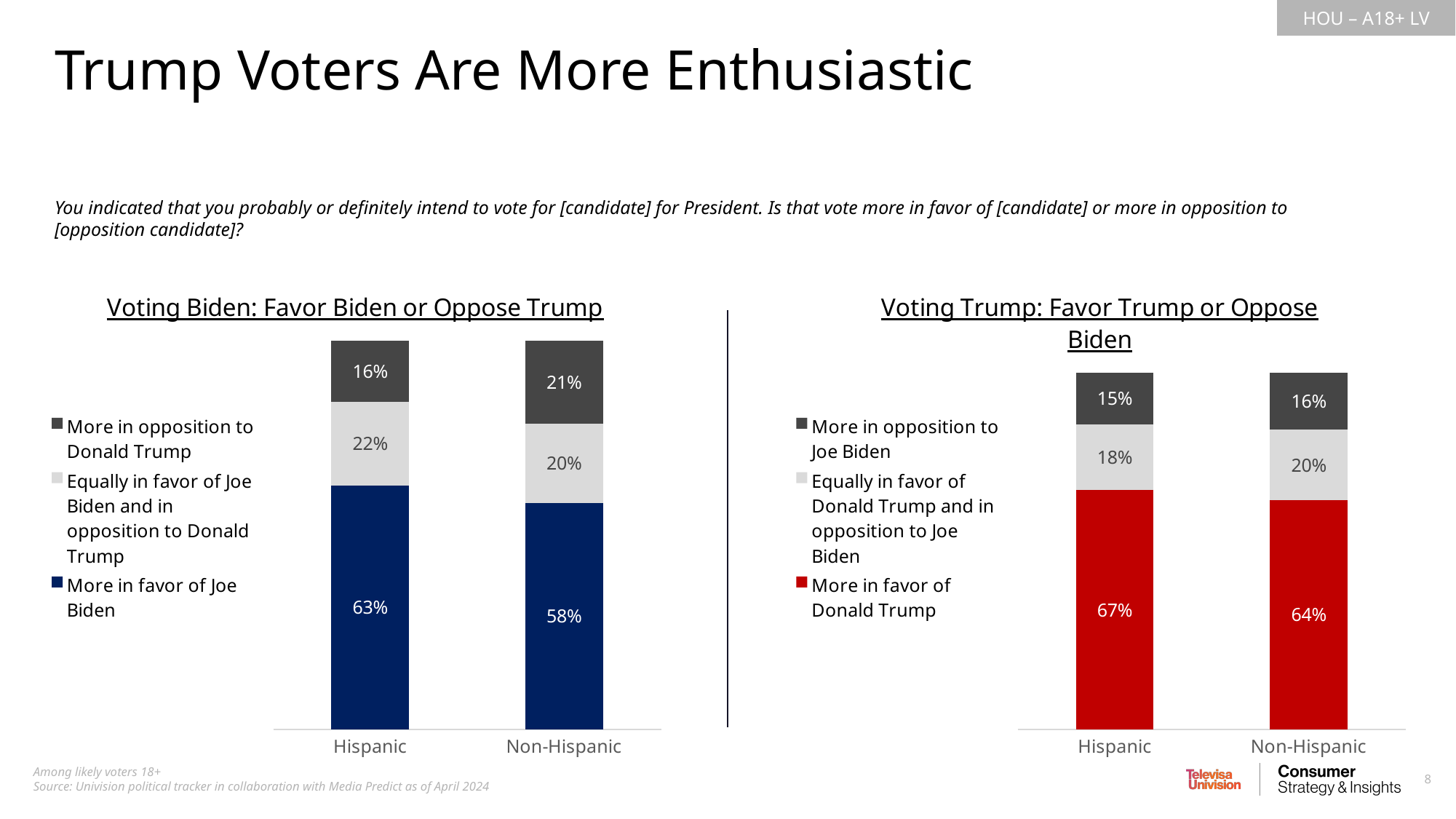
How many categories are shown on the x axis of the 'Voting Biden: Favor Biden or Oppose Trump' chart? 2 In the 'Voting Biden: Favor Biden or Oppose Trump' chart, which group has the higher 'More in opposition to Donald Trump' value, Hispanic or Non-Hispanic? Non-Hispanic In the 'Voting Trump: Favor Trump or Oppose Biden' chart, which group has the higher 'More in favor of Donald Trump' value, Hispanic or Non-Hispanic? Hispanic In the 'Voting Trump: Favor Trump or Oppose Biden' chart, what is the value for 'More in favor of Donald Trump' among Hispanic voters? 67% What kind of chart is the 'Voting Biden: Favor Biden or Oppose Trump' chart? Stacked bar chart In the 'Voting Trump: Favor Trump or Oppose Biden' chart, what is the total of the stacked bar for Hispanic voters? 100% In the 'Voting Biden: Favor Biden or Oppose Trump' chart, what is the value for 'More in favor of Joe Biden' among Hispanic voters? 63% In the 'Voting Biden: Favor Biden or Oppose Trump' chart, what is the difference between the 'More in favor of Joe Biden' values for Hispanic and Non-Hispanic voters? 5% In the 'Voting Biden: Favor Biden or Oppose Trump' chart, what is the value for 'More in opposition to Donald Trump' among Non-Hispanic voters? 21% In the 'Voting Trump: Favor Trump or Oppose Biden' chart, what colour represents 'More in favor of Donald Trump'? Red In the 'Voting Trump: Favor Trump or Oppose Biden' chart, what is the value for 'Equally in favor of Donald Trump and in opposition to Joe Biden' among Non-Hispanic voters? 20% How many series does the legend of the 'Voting Trump: Favor Trump or Oppose Biden' chart list? 3